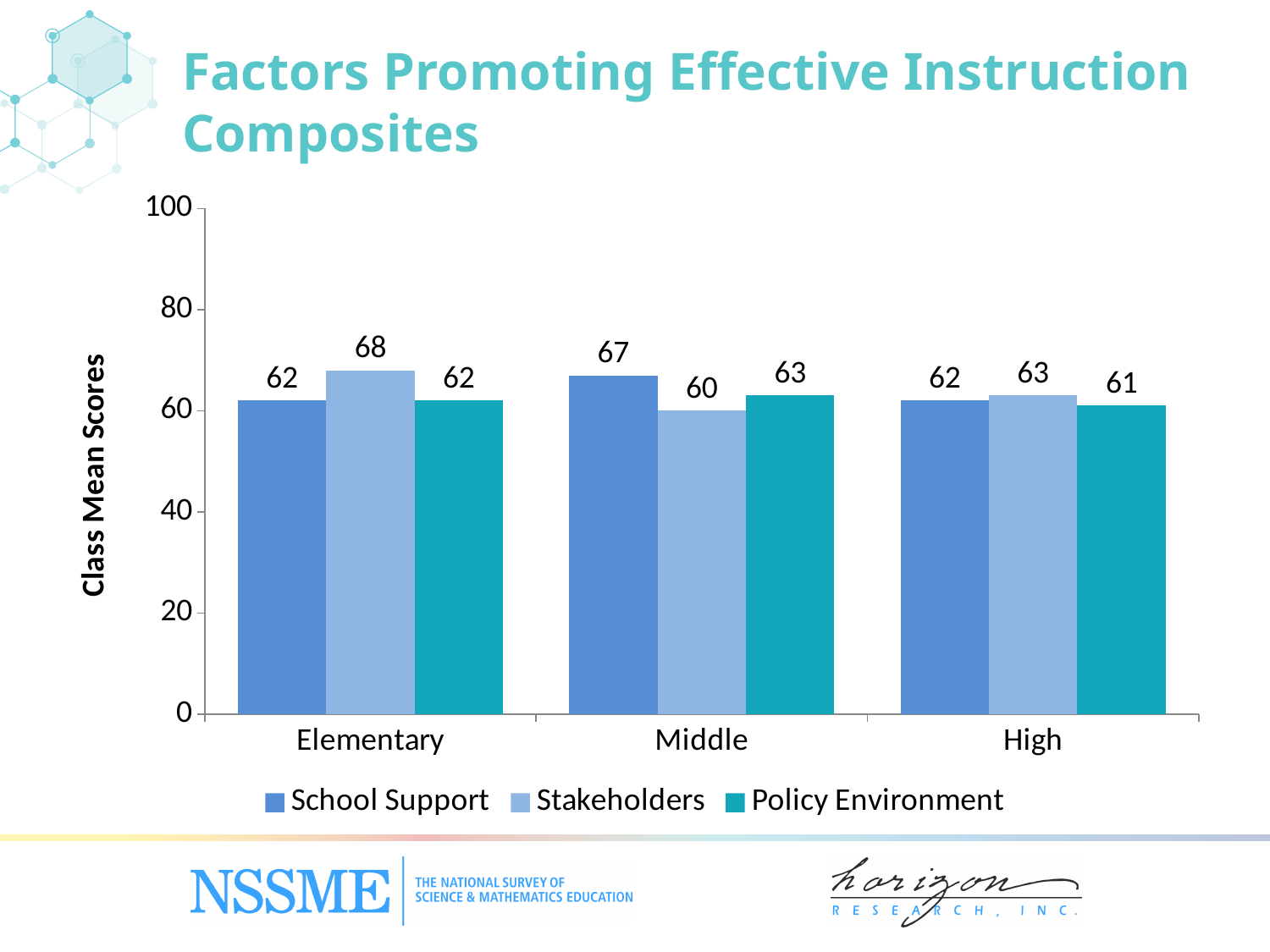
What is the School Support class mean score for Middle? 67 What kind of chart is shown on the slide? Bar chart What is the label of the y axis? Class Mean Scores How many series does the legend list? 3 What is the Stakeholders class mean score for Elementary? 68 Which school level has the lowest Stakeholders score? Middle What is the difference between the School Support and Stakeholders scores for Middle? 7 Which is larger for Elementary: the Stakeholders score or the School Support score? Stakeholders What is the Stakeholders class mean score for Middle? 60 How many school levels are shown on the x axis? 3 What is the Policy Environment class mean score for High? 61 Which school level has the highest Stakeholders score? Elementary